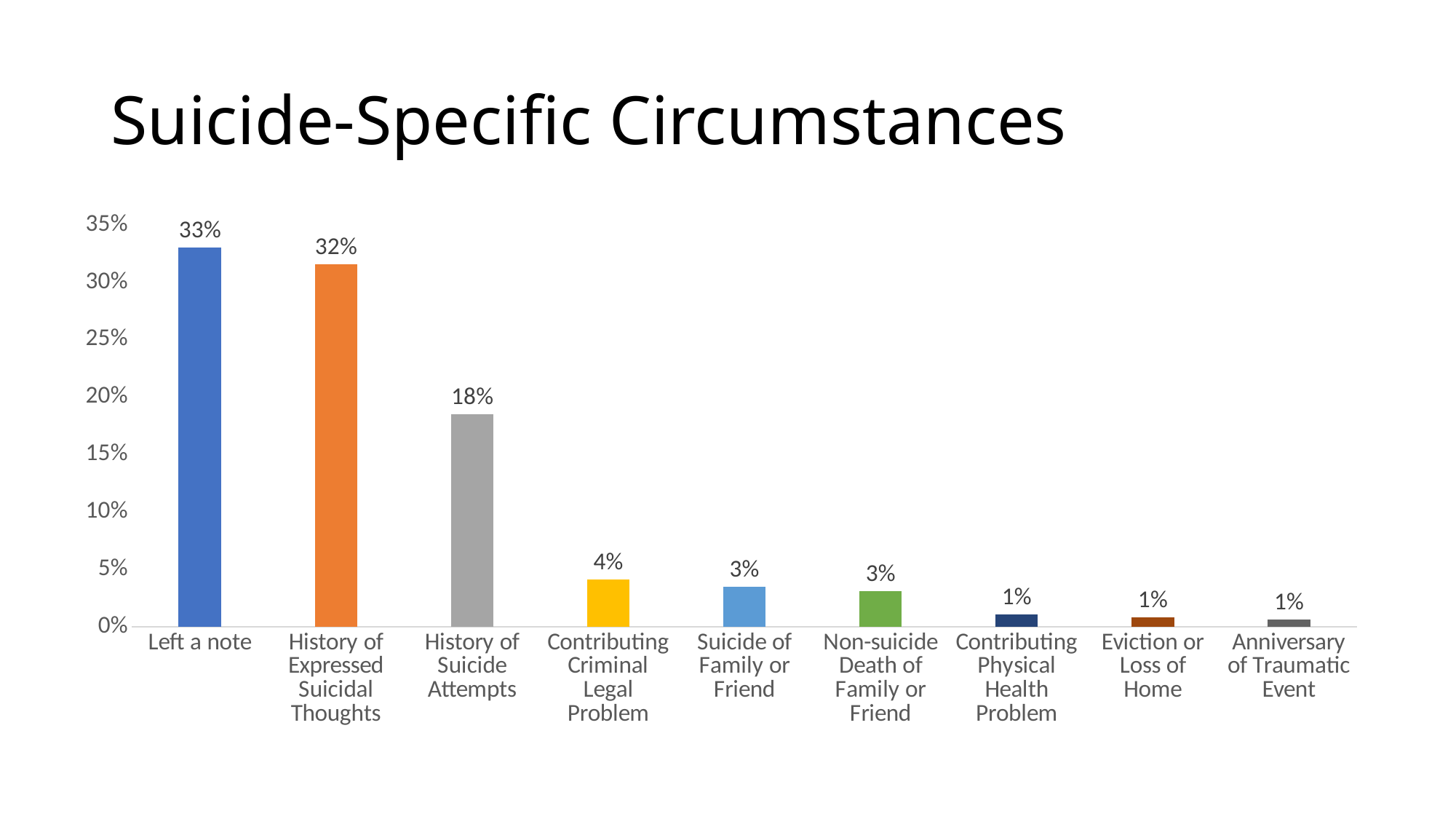
Do the values rise or fall from left to right along the x axis? fall What is the difference between the values for History of Expressed Suicidal Thoughts and History of Suicide Attempts? 14% What is the value for History of Suicide Attempts? 18% What is the value for Eviction or Loss of Home? 1% What is the value for Left a note? 33% What is the title of the slide? Suicide-Specific Circumstances Which is larger, the value for Contributing Criminal Legal Problem or the value for Suicide of Family or Friend? Contributing Criminal Legal Problem Which category has the highest value? Left a note What kind of chart is shown on the slide? bar chart What is the value for Contributing Criminal Legal Problem? 4% Is the value for History of Suicide Attempts greater or less than 20%? less How many categories are shown on the chart? 9